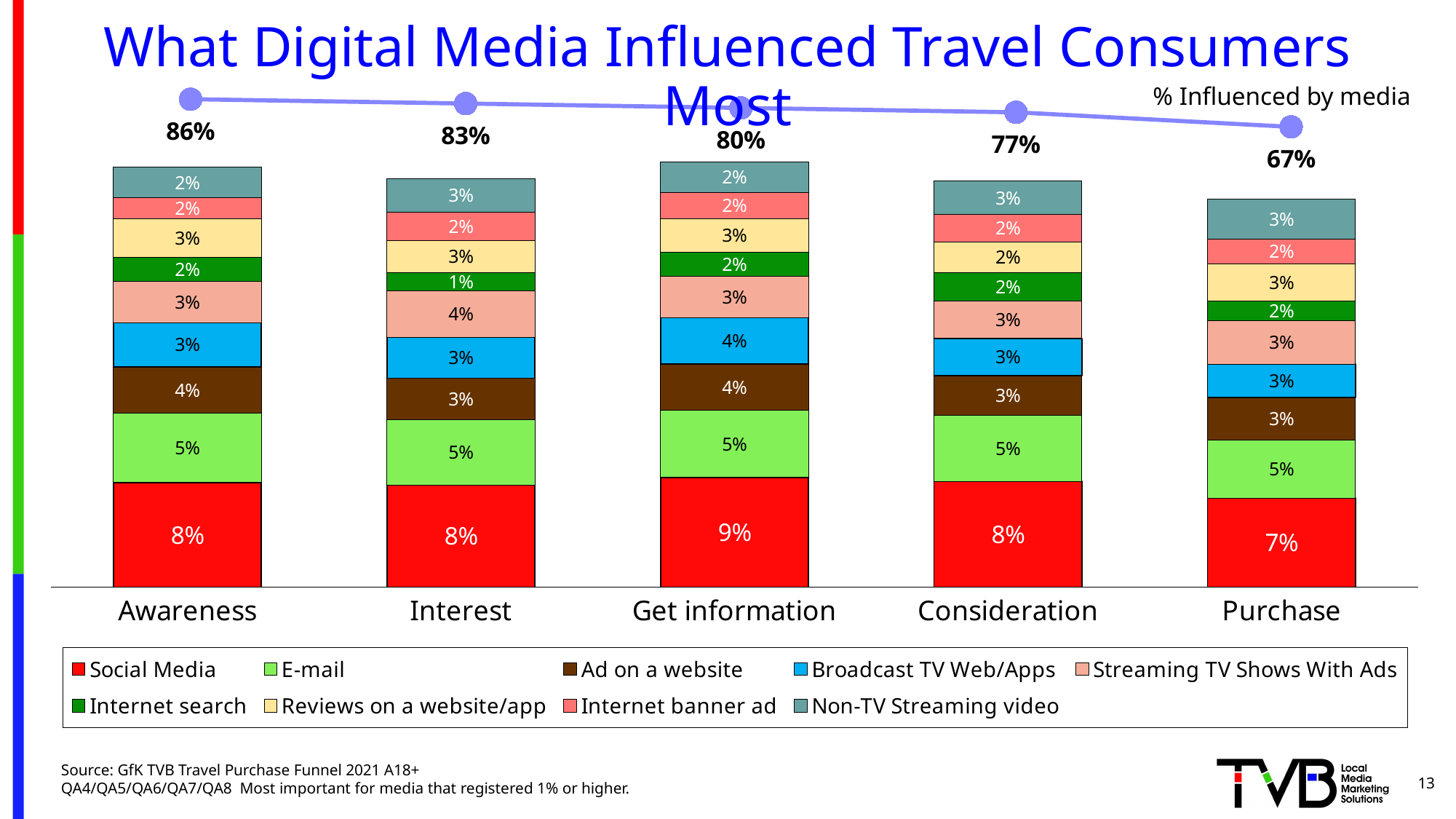
What is the Social Media value for the Get information stage? 9% Which stage has the lowest Social Media value? Purchase Which has a larger Social Media value, Get information or Consideration? Get information How many stages are shown along the x axis? 5 What is the difference between the % Influenced by media values for Awareness and Purchase? 19% What is the % Influenced by media value for Purchase? 67% What kind of chart is this? Stacked bar chart with a line Does the % Influenced by media line rise or fall from Awareness to Purchase? Fall Which stage has the highest % Influenced by media value? Awareness What is the E-mail value for Consideration? 5% How many series does the legend list? 9 What is the Internet search value for the Interest stage? 1%